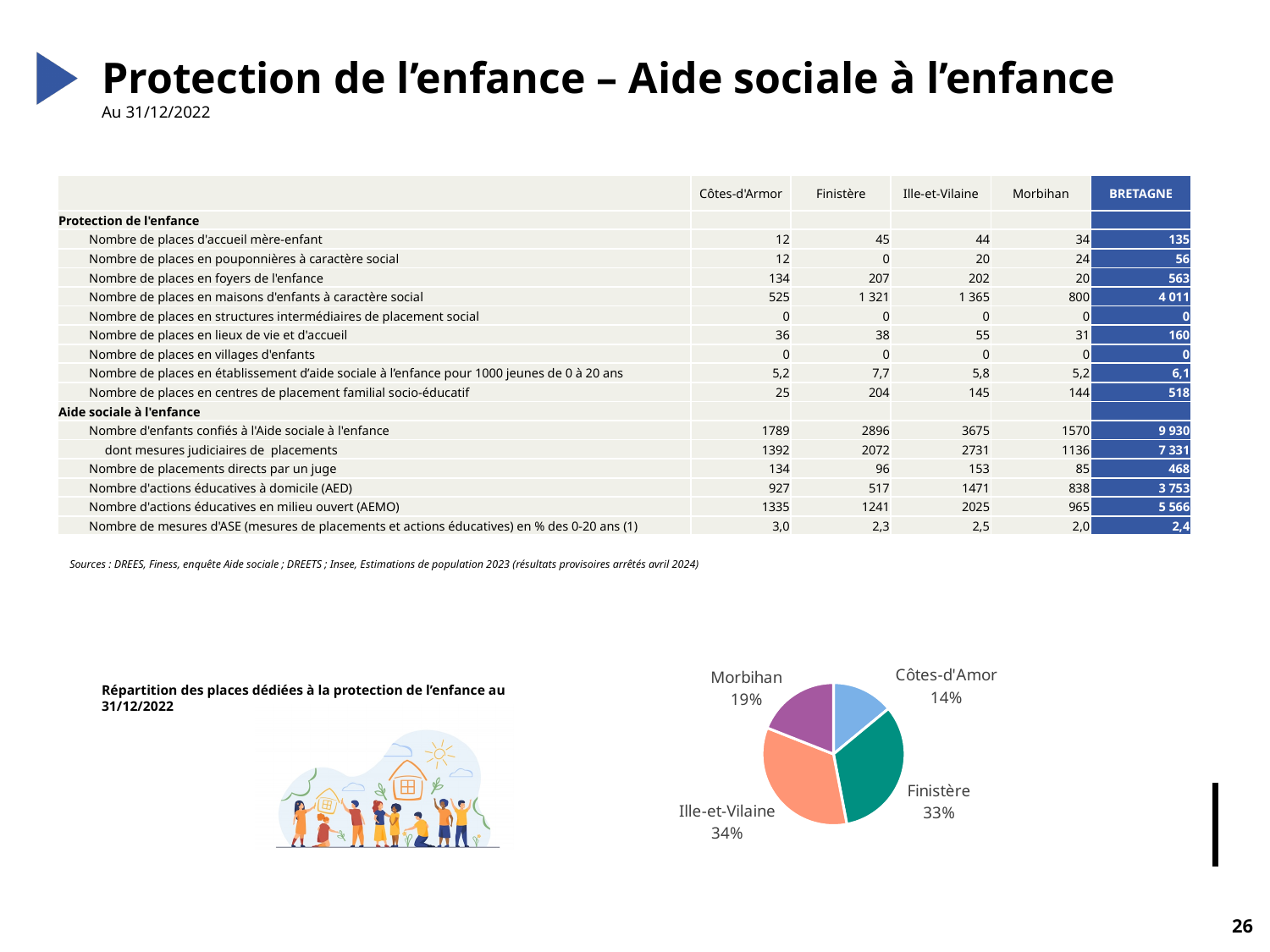
In the pie chart, which is larger: the share for Morbihan or the share for Côtes-d'Amor? Morbihan What kind of chart is shown at the bottom of the slide? pie chart What is the title of the pie chart on the slide? Répartition des places dédiées à la protection de l'enfance au 31/12/2022 In the pie chart, what is the difference in percentage points between the Finistère share and the Côtes-d'Amor share? 19 Which department has the smallest slice in the pie chart? Côtes-d'Amor In the pie chart, what share of places is attributed to Finistère? 33% Which department has the largest slice in the pie chart? Ille-et-Vilaine In the pie chart, what is the difference in percentage points between the Ille-et-Vilaine share and the Morbihan share? 15 In the pie chart, what share of places is attributed to Ille-et-Vilaine? 34% In the pie chart, what share of places is attributed to Côtes-d'Amor? 14% How many slices does the pie chart have? 4